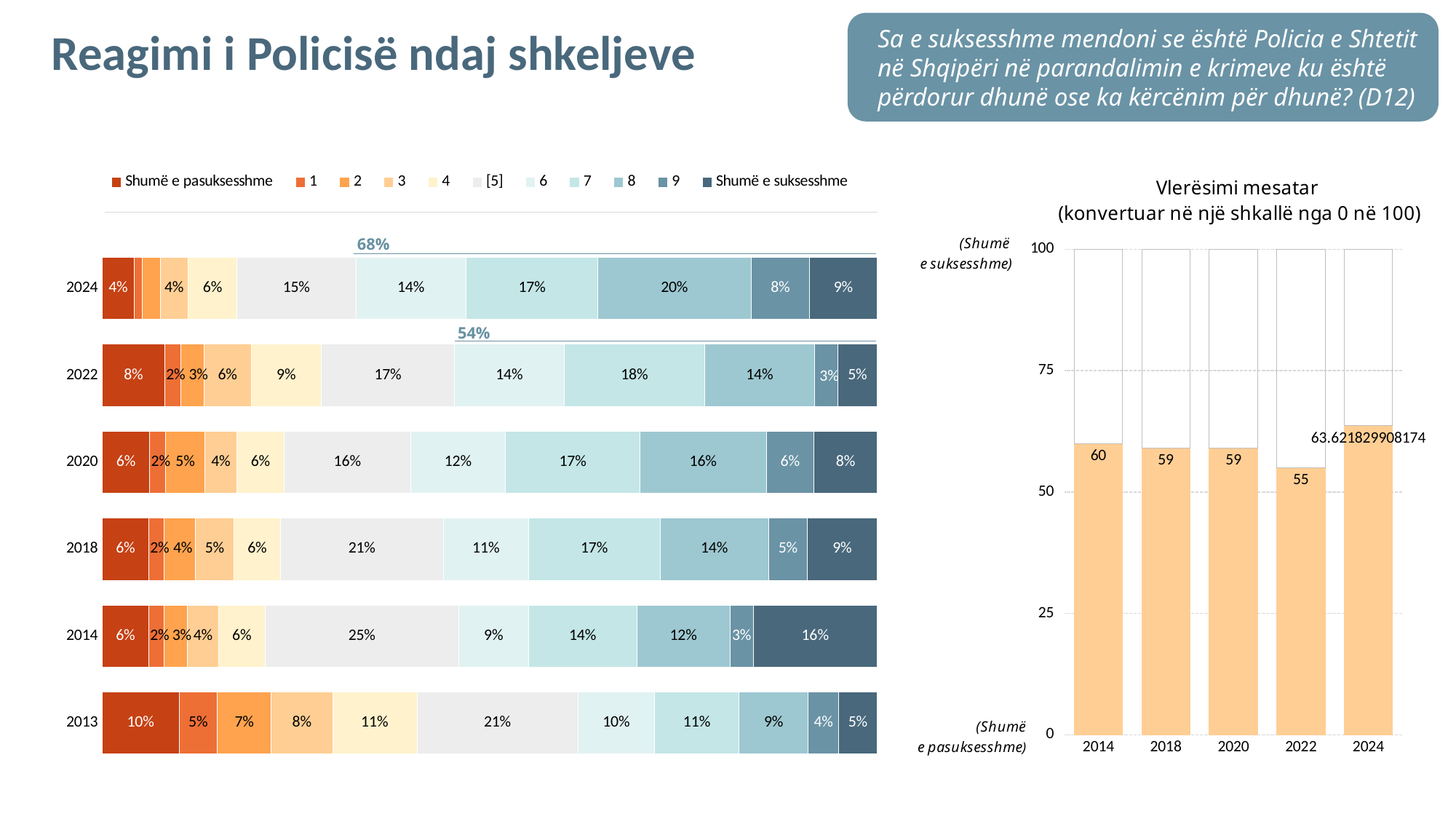
In the left stacked bar chart, what is the value of the "[5]" segment for 2018? 21% How many series does the legend of the left stacked bar chart list? 11 In the chart titled "Vlerësimi mesatar", what is the value for 2022? 55 In the chart titled "Vlerësimi mesatar", which year has the highest value? 2024 In the left stacked bar chart, is the "Shumë e suksesshme" share larger in 2014 or in 2022? 2014 In the left stacked bar chart, what percentage of respondents in 2024 answered "Shumë e suksesshme"? 9% In the left stacked bar chart, which response category has the largest segment in the 2024 bar? 8 In the chart titled "Vlerësimi mesatar", which year has the lowest value? 2022 In the chart titled "Vlerësimi mesatar", what is the difference between the values for 2014 and 2022? 5 In the left stacked bar chart, how many years (bars) are shown? 6 In the left stacked bar chart, what percentage of respondents in 2013 answered "Shumë e pasuksesshme"? 10% What kind of chart is the chart titled "Vlerësimi mesatar"? Bar chart